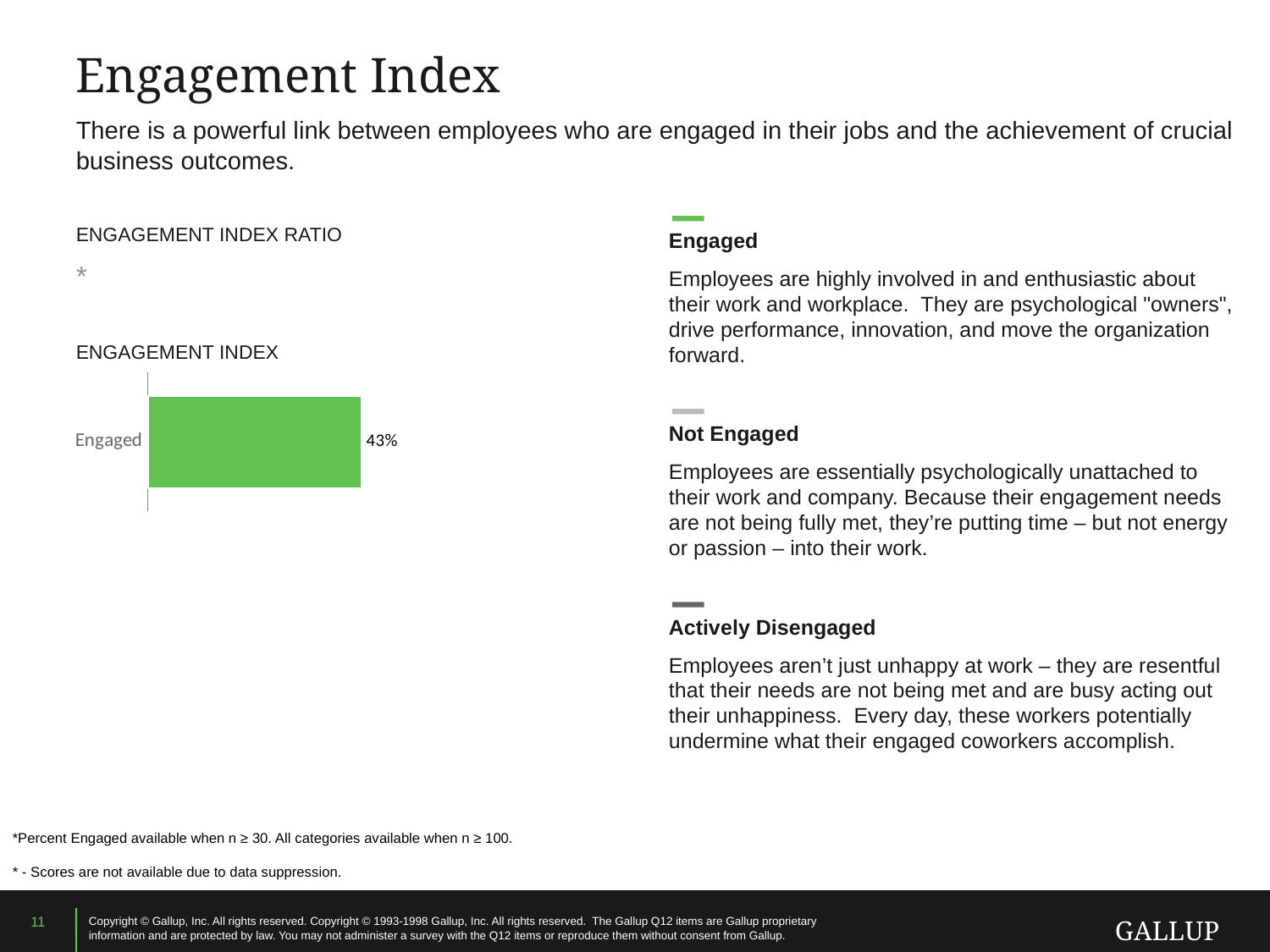
How many categories are plotted in the Engagement Index chart? 1 In the Engagement Index chart, what is the value for Engaged? 43% What is the title of the chart on the slide? ENGAGEMENT INDEX What kind of chart is the Engagement Index chart? bar chart What colour is the Engaged bar in the Engagement Index chart? green